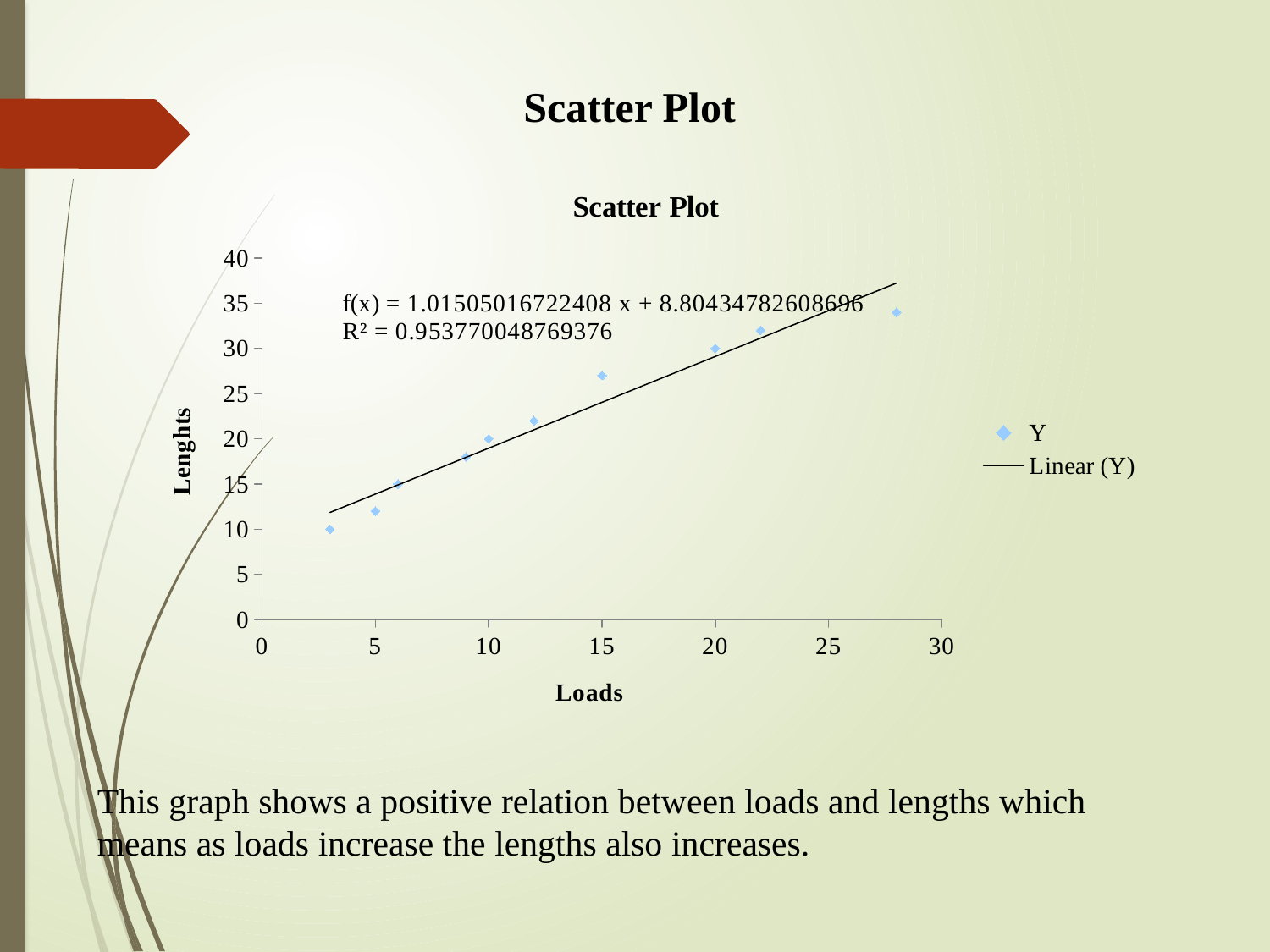
How many data points are plotted in the scatter plot? 10 What R² value is printed on the chart? 0.953770048769376 Is the length value for the point at load 28 greater or less than 30? greater Is the length value for the point at load 5 greater or less than 15? less What is the label of the x axis? Loads Is the length value for the point at load 15 greater or less than 25? greater What kind of chart is shown on the slide? scatter plot How many entries does the legend list? 2 Do the plotted lengths rise or fall as loads increase along the x axis? rise Which plotted point has the highest length value: the one at load 28 or the one at load 3? the one at load 28